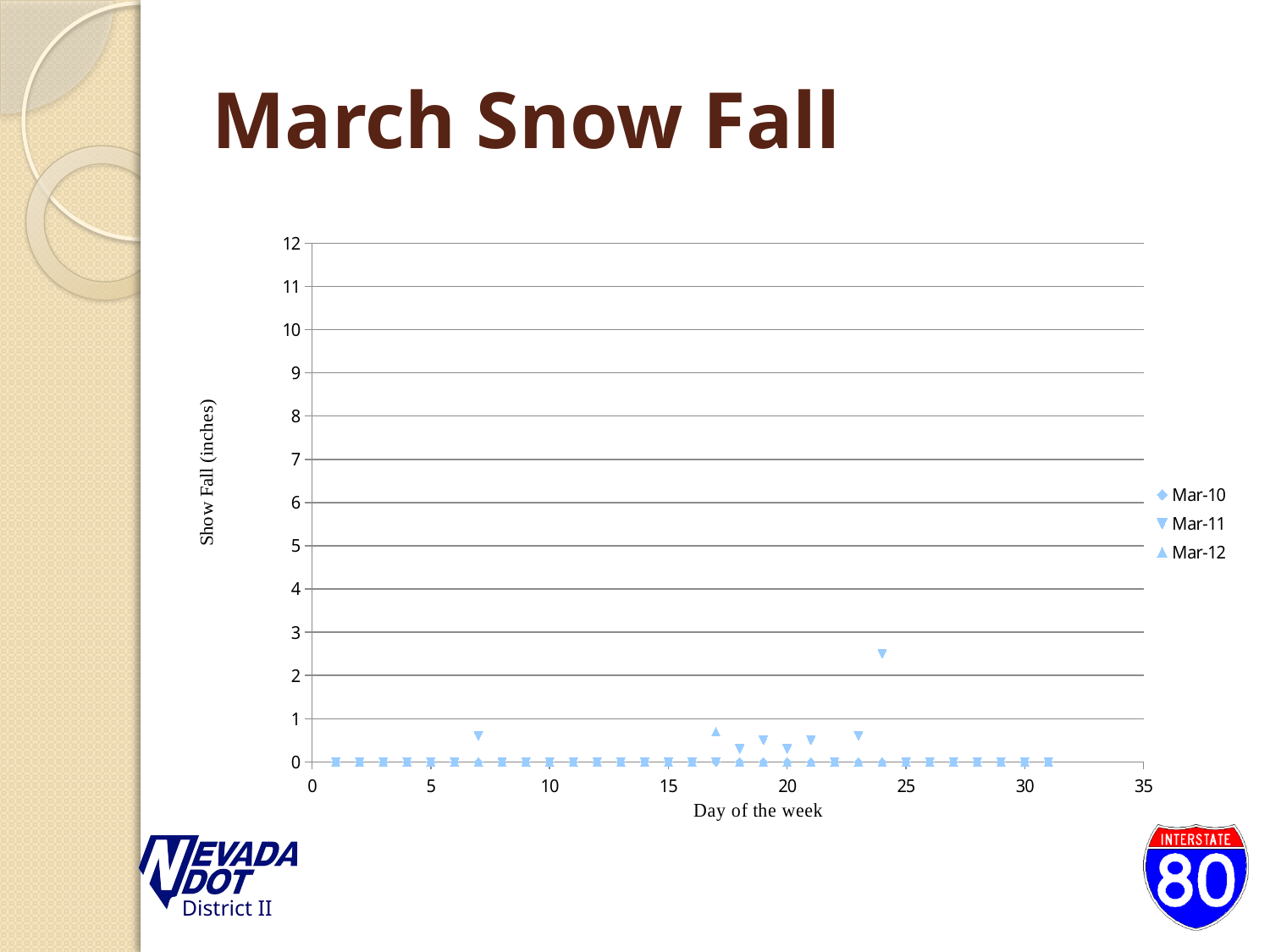
On which day of the month does the highest snowfall point occur? 24 Is the Mar-11 value on day 24 greater or less than 3? less Which series contains the highest plotted point on the chart? Mar-11 Is the Mar-12 value on day 17 greater or less than 1? less What are the three series named in the legend? Mar-10, Mar-11, Mar-12 Is the Mar-11 value on day 24 greater or less than 2? greater What kind of chart is shown on the slide? scatter chart How many series does the legend list? 3 What is the highest value shown on the vertical axis? 12 What is the title of the vertical axis? Show Fall (inches) Which is larger: the Mar-11 value on day 24 or the Mar-12 value on day 17? Mar-11 value on day 24